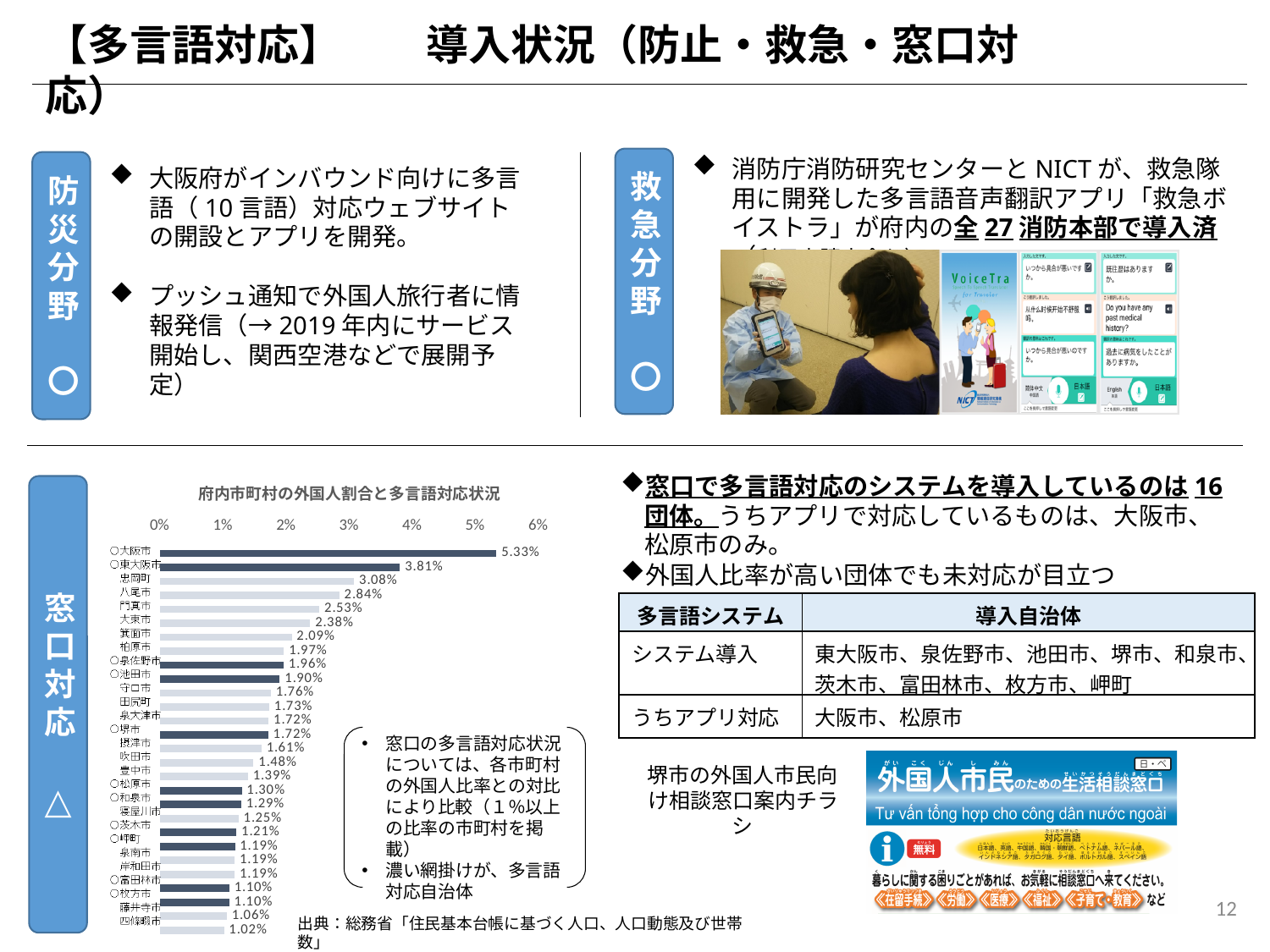
What is the title of the chart on the slide? 府内市町村の外国人割合と多言語対応状況 How many municipalities are shown in the chart? 28 What is the value for 東大阪市 in the chart? 3.81% Which has a larger value, 忠岡町 or 八尾市? 忠岡町 What is the value for 大阪市 in the chart? 5.33% What type of chart is shown on the slide? bar chart What is the value for 松原市 in the chart? 1.30% What is the value for 堺市 in the chart? 1.72% What is the difference between the values for 大阪市 and 東大阪市? 1.52% Is the value for 門真市 greater or less than 2%? greater Which municipality has the lowest value in the chart? 四條畷市 Which municipality has the highest value in the chart? 大阪市